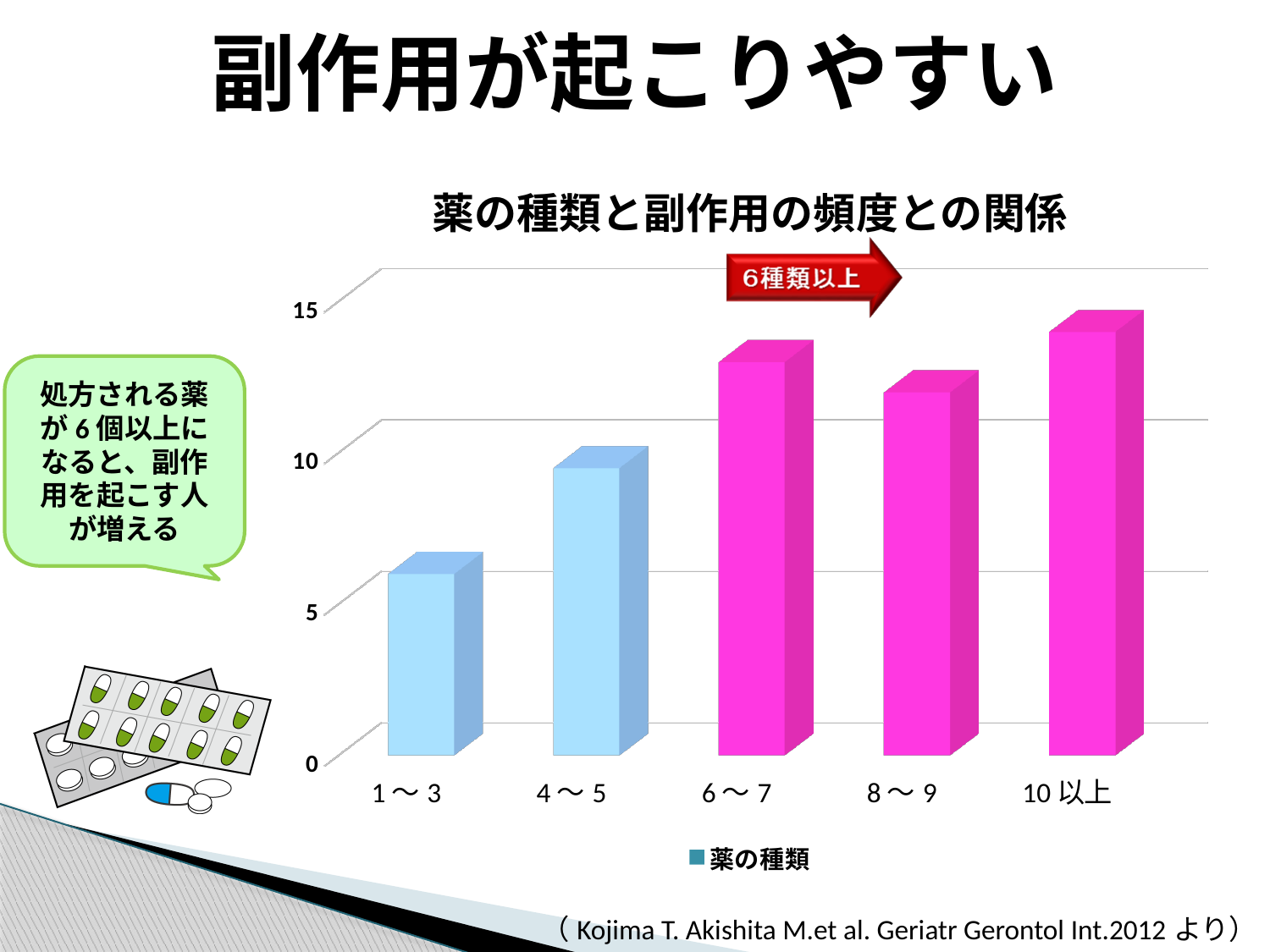
Which category has the highest bar in the chart? 10以上 How many series does the chart legend list? 1 Which is larger, the value for 1～3 or the value for 4～5? 4～5 What series name is shown in the chart legend? 薬の種類 Which category has the lowest bar in the chart? 1～3 How many categories are shown on the x axis of the chart? 5 Is the value for 10以上 greater or less than 15? less Is the value for 6～7 greater or less than 10? greater Which is larger, the value for 6～7 or the value for 8～9? 6～7 What is the title of the chart? 薬の種類と副作用の頻度との関係 Is the value for 1～3 greater or less than 10? less What kind of chart is shown on the slide? bar chart